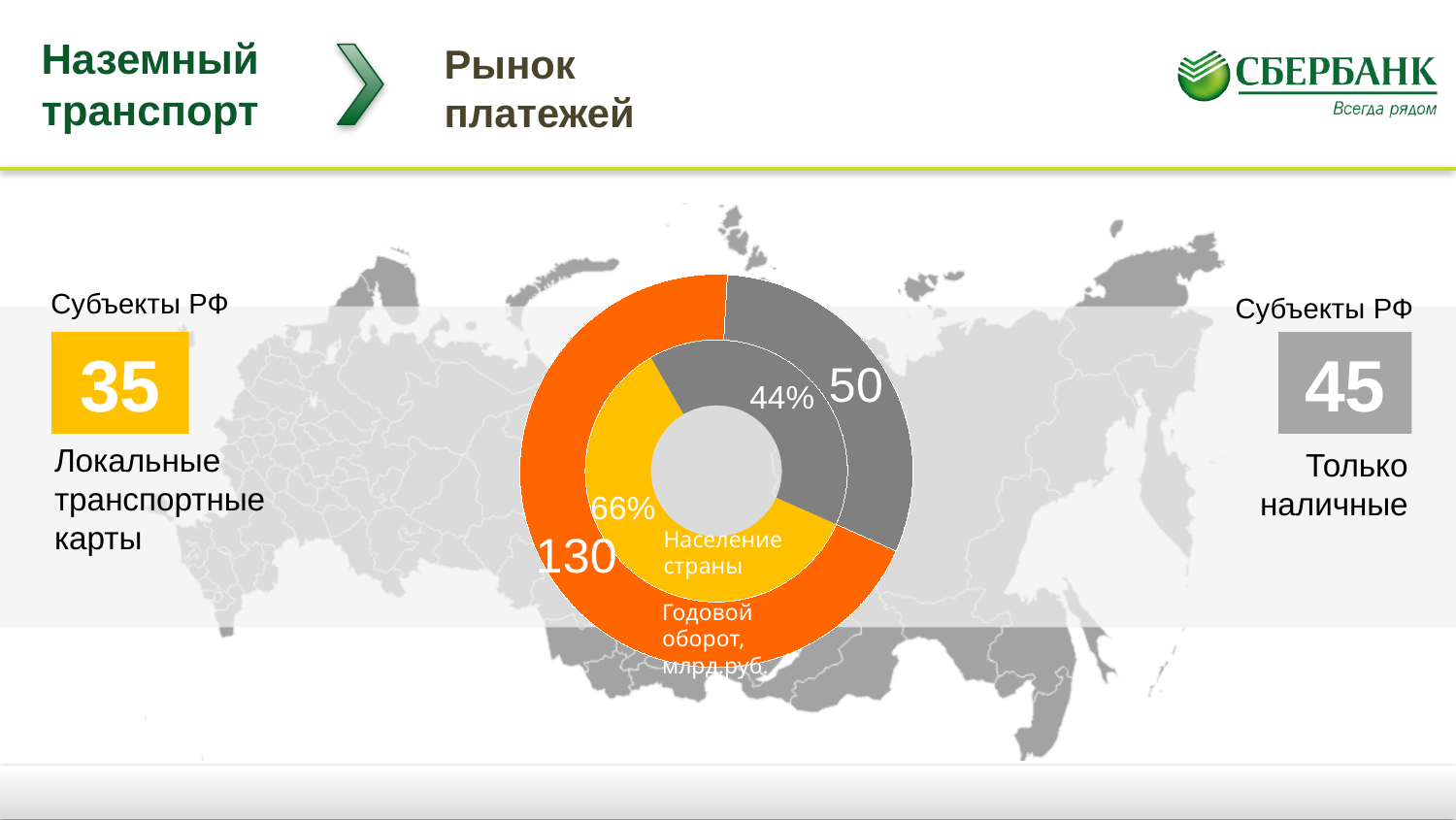
What is the difference between the two values in the outer ring, 130 and 50? 80 In the outer ring, which segment has the larger value, the orange one or the grey one? the orange one (130) What value is printed on the orange segment of the outer ring (Годовой оборот, млрд.руб.)? 130 How many rings does the doughnut chart have? 2 What is the label of the inner ring of the doughnut chart? Население страны What value is printed on the grey segment of the outer ring (Годовой оборот, млрд.руб.)? 50 What is the total of the two values shown in the outer ring? 180 What percentage is printed on the yellow segment of the inner ring (Население страны)? 66% What kind of chart is shown in the centre of the slide? doughnut chart What is the label of the outer ring of the doughnut chart? Годовой оборот, млрд.руб. Which segment of the inner ring (Население страны) is the largest? the yellow segment (66%) What percentage is printed on the grey segment of the inner ring (Население страны)? 44%